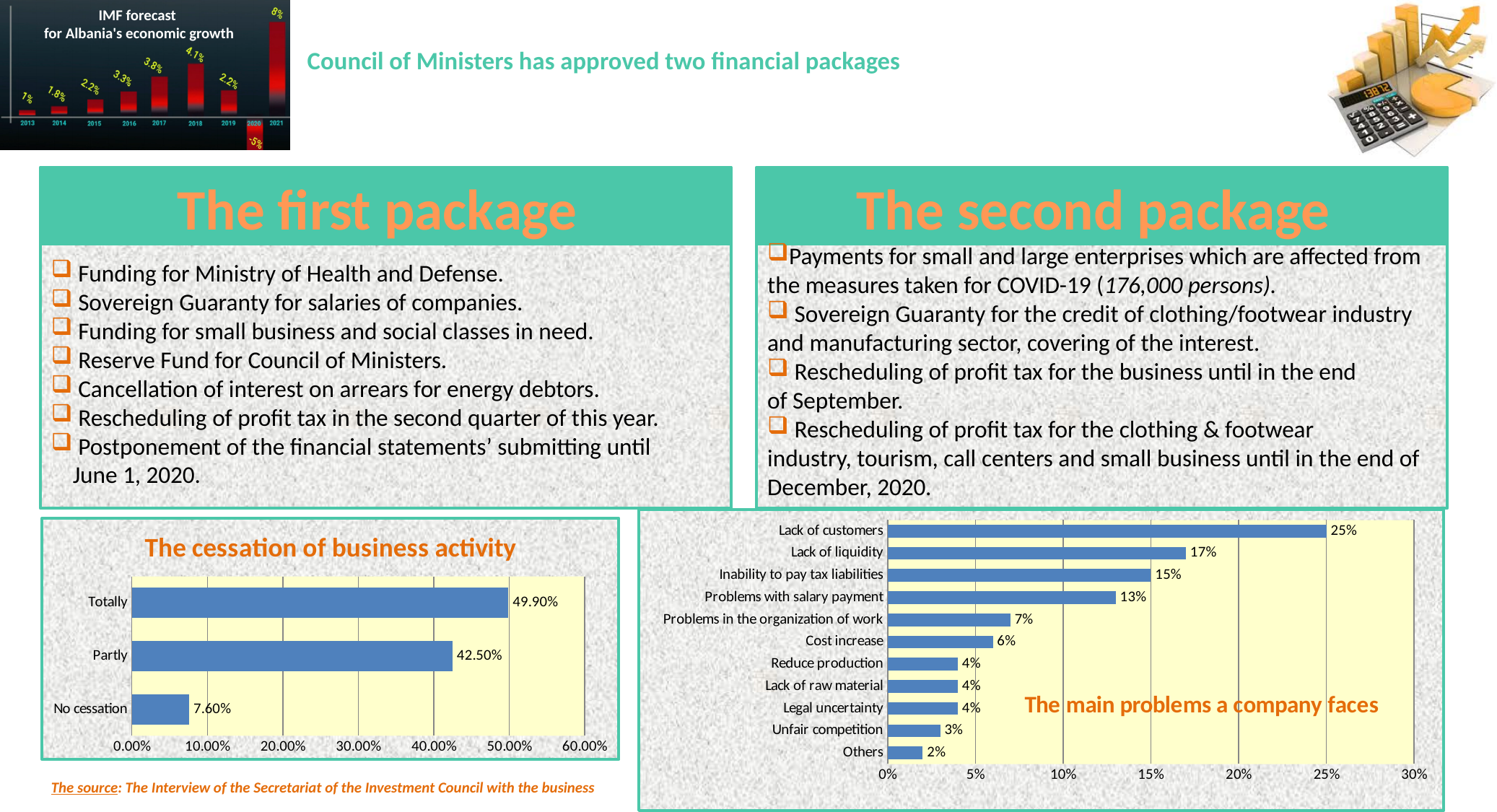
In the chart 'The main problems a company faces', which category has the highest value? Lack of customers What kind of chart is 'The main problems a company faces'? Bar chart In the chart 'The cessation of business activity', what is the value for No cessation? 7.60% In the chart 'The main problems a company faces', what is the difference between Lack of customers and Inability to pay tax liabilities? 10% In the chart 'The cessation of business activity', how many categories are shown? 3 In the chart 'The main problems a company faces', what is the value for Lack of liquidity? 17% In the chart 'The main problems a company faces', what is the value for Others? 2% In the chart 'The cessation of business activity', what is the value for Totally? 49.90% In the chart 'The main problems a company faces', how many categories are shown? 11 In the chart 'The cessation of business activity', what is the difference between Totally and Partly? 7.40% In the chart 'The cessation of business activity', which category has the lowest value? No cessation In the chart 'The main problems a company faces', which is larger: Problems with salary payment or Cost increase? Problems with salary payment